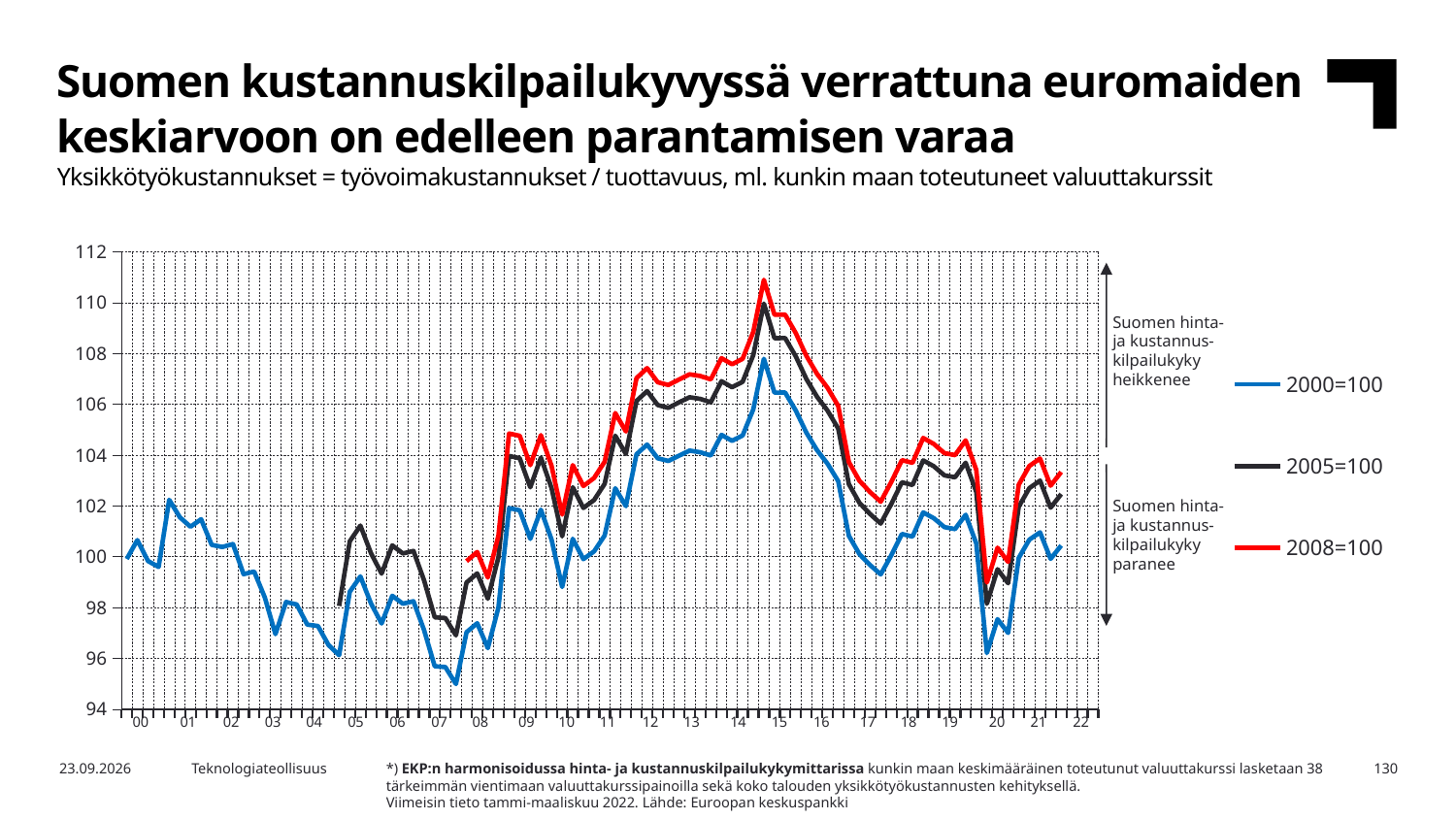
Does the 2000=100 series rise or fall between 2015 and 2017? fall How many series does the chart legend list? 3 Is the lowest value of the 2000=100 series around 2007 greater or less than 96? less What are the three series named in the legend? 2000=100, 2005=100, 2008=100 What kind of chart is shown on the slide? line chart At the 2014–15 peak, which series has the higher value: 2008=100 or 2000=100? 2008=100 How many year labels are shown on the x axis (from 00 to 22)? 23 Which series is drawn in red? 2008=100 Is the peak value of the 2000=100 series around 2014–15 greater or less than 106? greater Which series runs lowest on the chart over the period from 2009 onwards? 2000=100 Is the peak value of the 2008=100 series around 2014–15 greater or less than 110? greater